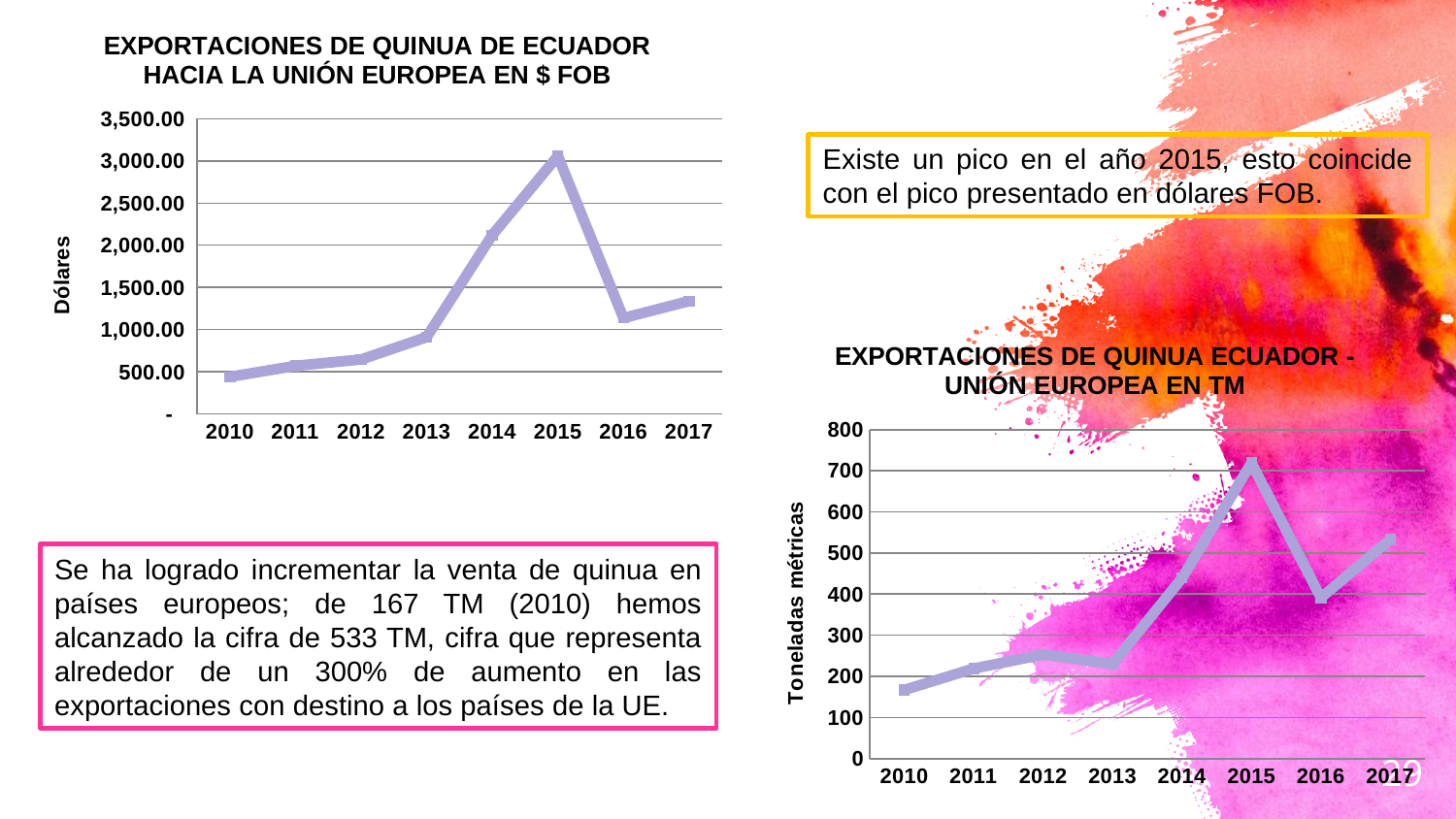
What kind of chart is the chart titled 'EXPORTACIONES DE QUINUA DE ECUADOR HACIA LA UNIÓN EUROPEA EN $ FOB'? Line chart In the chart 'EXPORTACIONES DE QUINUA DE ECUADOR HACIA LA UNIÓN EUROPEA EN $ FOB', is the value for 2015 greater or less than 2,500.00? greater In the chart 'EXPORTACIONES DE QUINUA DE ECUADOR HACIA LA UNIÓN EUROPEA EN $ FOB', which year has the highest value? 2015 In the chart 'EXPORTACIONES DE QUINUA DE ECUADOR HACIA LA UNIÓN EUROPEA EN $ FOB', how many years are shown on the x axis? 8 In the chart 'EXPORTACIONES DE QUINUA ECUADOR - UNIÓN EUROPEA EN TM', which year has the lowest value? 2010 In the chart 'EXPORTACIONES DE QUINUA ECUADOR - UNIÓN EUROPEA EN TM', which year has the highest value? 2015 What is the y-axis label of the chart 'EXPORTACIONES DE QUINUA ECUADOR - UNIÓN EUROPEA EN TM'? Toneladas métricas In the chart 'EXPORTACIONES DE QUINUA DE ECUADOR HACIA LA UNIÓN EUROPEA EN $ FOB', which year has the larger value, 2016 or 2017? 2017 In the chart 'EXPORTACIONES DE QUINUA ECUADOR - UNIÓN EUROPEA EN TM', is the value for 2016 greater or less than 500? less In the chart 'EXPORTACIONES DE QUINUA ECUADOR - UNIÓN EUROPEA EN TM', do the values rise or fall from 2013 to 2015? rise In the chart 'EXPORTACIONES DE QUINUA DE ECUADOR HACIA LA UNIÓN EUROPEA EN $ FOB', is the value for 2016 greater or less than 1,500.00? less In the chart 'EXPORTACIONES DE QUINUA DE ECUADOR HACIA LA UNIÓN EUROPEA EN $ FOB', which year has the lowest value? 2010